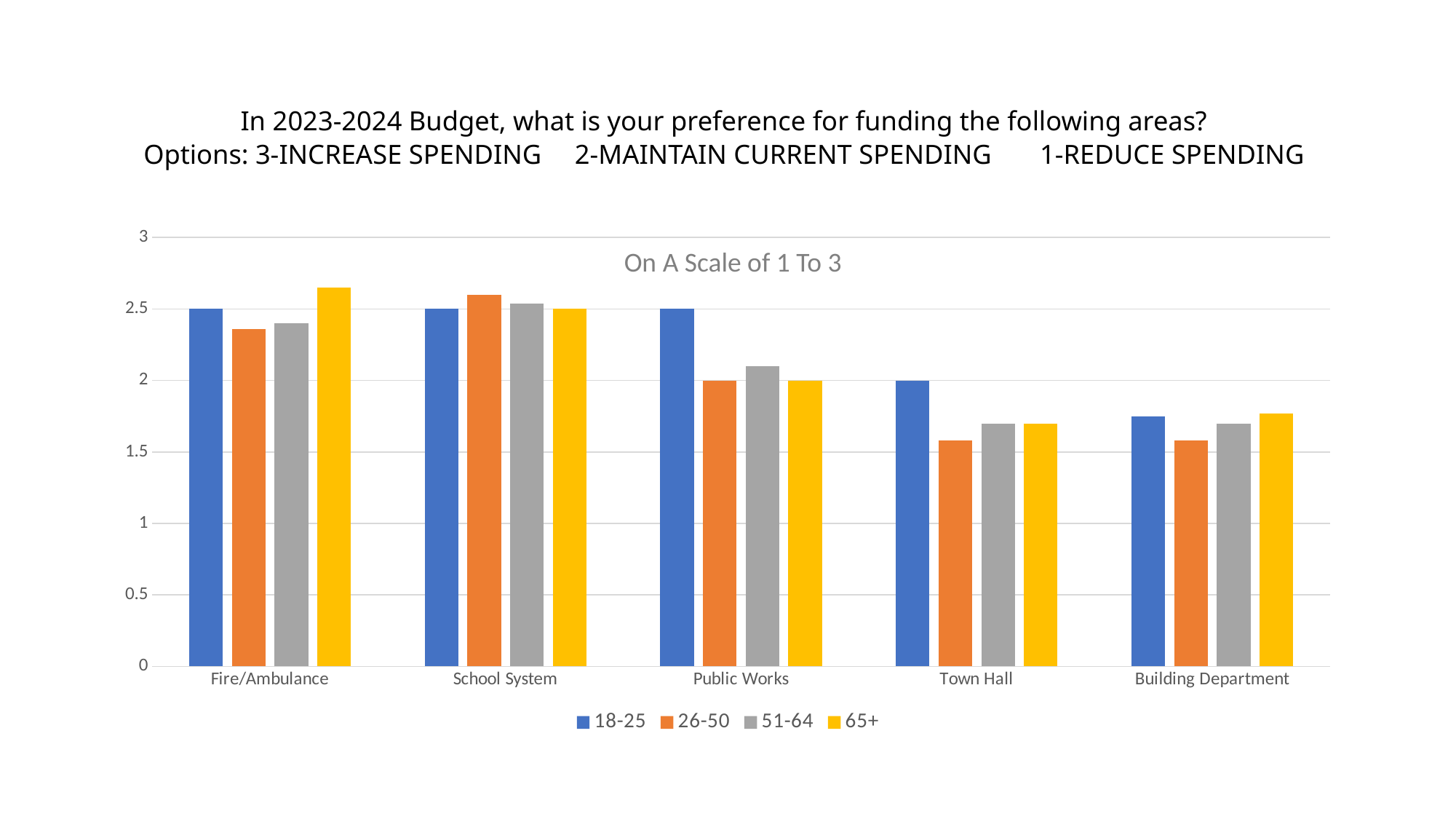
How many age-group series does the legend list? 4 Which age group gives the lowest rating for Town Hall? 26-50 Which age group gives the highest rating for Public Works? 18-25 What subtitle text appears inside the plot area of the chart? On A Scale of 1 To 3 Is the 26-50 value for Town Hall greater or less than 2? less Which age group gives the highest rating for Fire/Ambulance? 65+ How many funding areas (categories) are shown on the x axis? 5 For Town Hall, which is larger: the 18-25 value or the 26-50 value? 18-25 For Fire/Ambulance, which is larger: the 65+ value or the 26-50 value? 65+ Is the 51-64 value for Building Department greater or less than 2? less What kind of chart is shown on the slide? bar chart Is the 65+ value for Fire/Ambulance greater or less than 2.5? greater